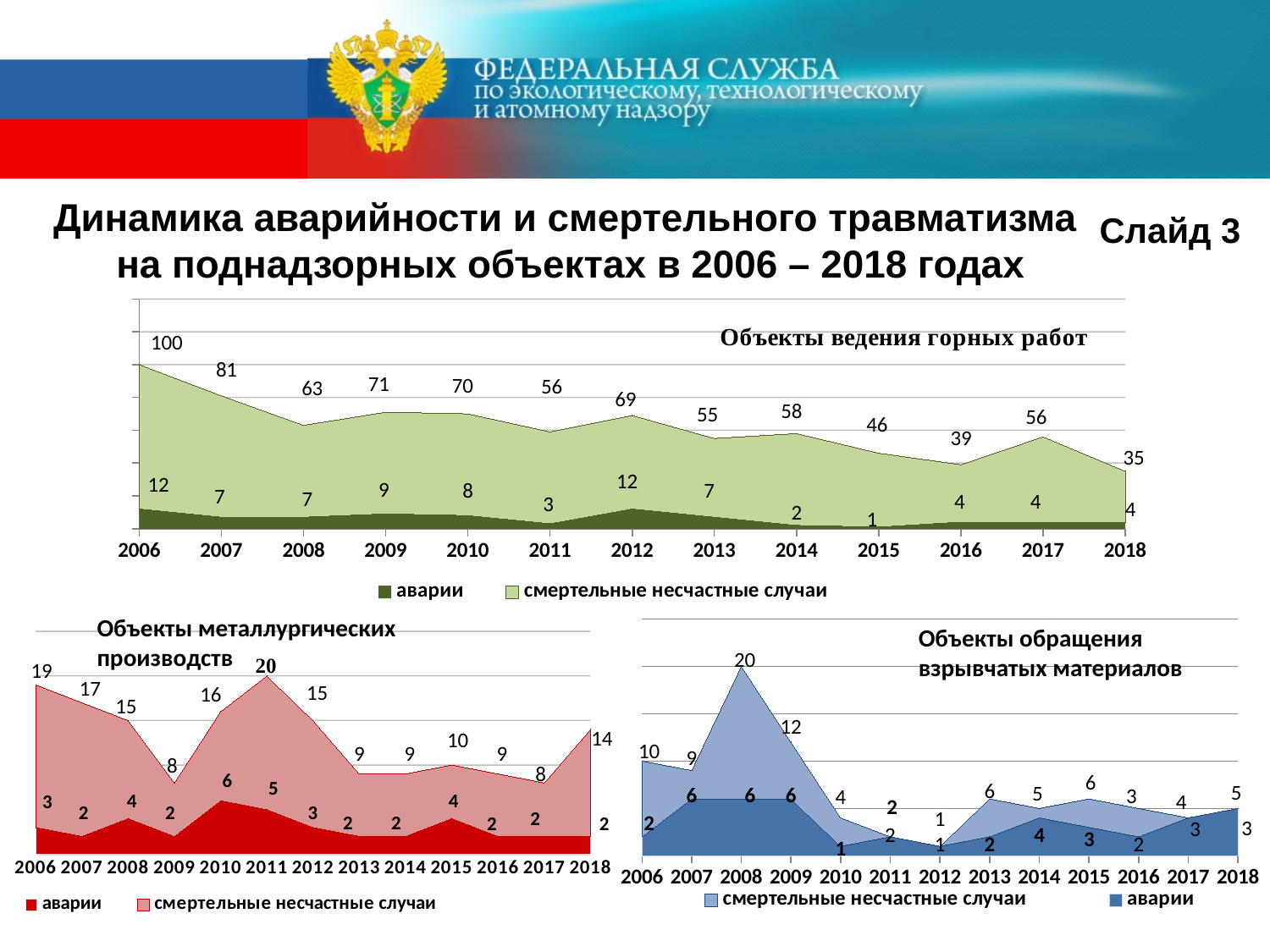
In the chart 'Объекты металлургических производств', how many years are shown on the x axis? 13 In the chart 'Объекты ведения горных работ', what is the value of 'аварии' for 2012? 12 In the chart 'Объекты ведения горных работ', what is the value of 'смертельные несчастные случаи' for 2006? 100 In the chart 'Объекты обращения взрывчатых материалов', what is the value of 'смертельные несчастные случаи' for 2008? 20 In the chart 'Объекты металлургических производств', what is the value of 'аварии' for 2010? 6 In the chart 'Объекты ведения горных работ', what is the difference between 'смертельные несчастные случаи' in 2006 and in 2018? 65 In the chart 'Объекты ведения горных работ', which year has the lowest value of 'смертельные несчастные случаи'? 2018 In the chart 'Объекты обращения взрывчатых материалов', what is the difference between 'смертельные несчастные случаи' in 2008 and in 2009? 8 What type of chart is 'Объекты ведения горных работ'? Area chart In the chart 'Объекты металлургических производств', which year has the highest value of 'смертельные несчастные случаи'? 2011 In the chart 'Объекты обращения взрывчатых материалов', which is larger: 'аварии' in 2007 or 'аварии' in 2010? 2007 In the chart 'Объекты ведения горных работ', how many series does the legend list? 2